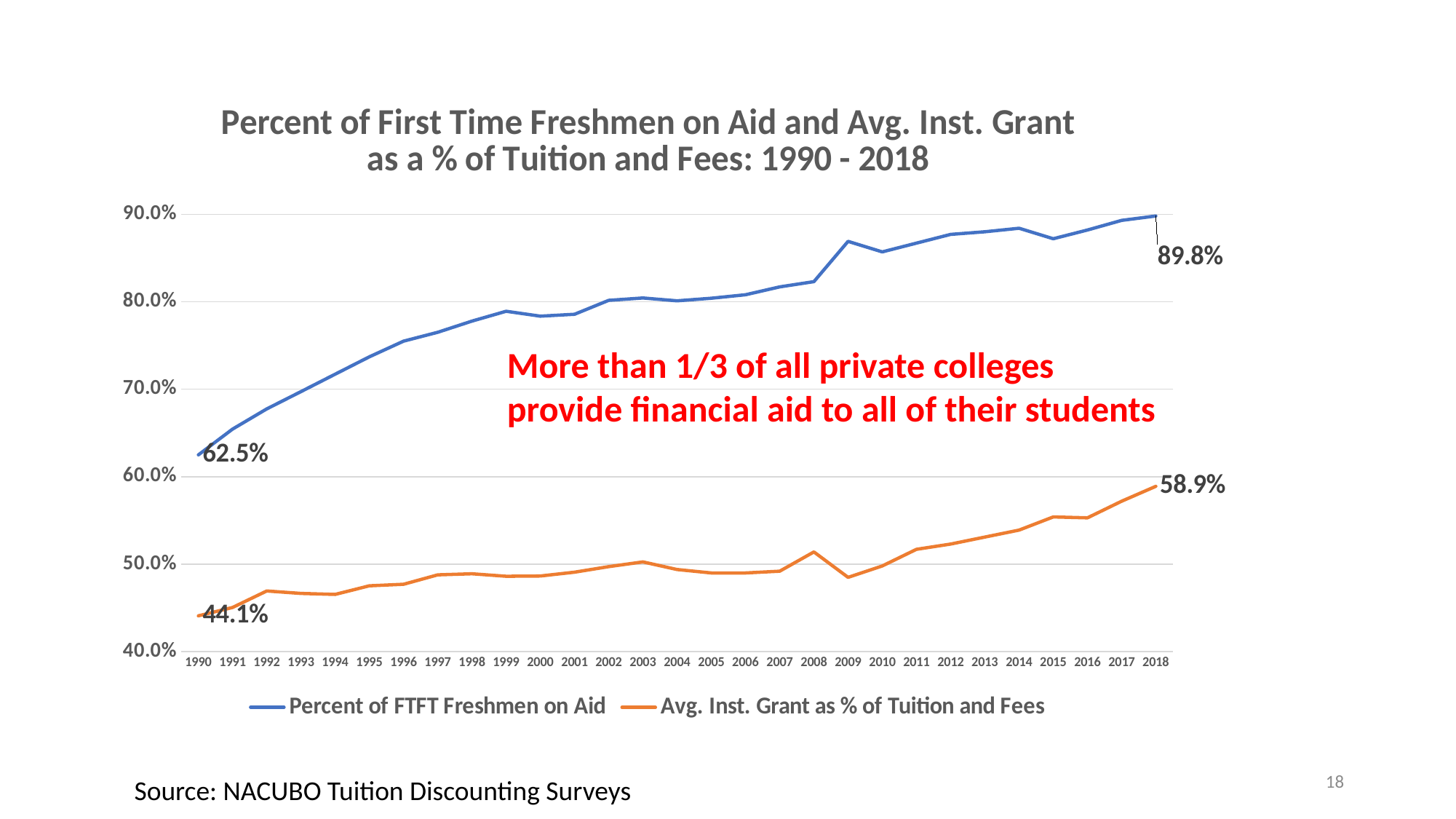
How many series does the legend list? 2 What is the value of Percent of FTFT Freshmen on Aid in 1990? 62.5% Is the value for Avg. Inst. Grant as % of Tuition and Fees in 2000 greater or less than 50.0%? less What is the value of Avg. Inst. Grant as % of Tuition and Fees in 2018? 58.9% What kind of chart is shown on the slide? Line chart Is the value for Percent of FTFT Freshmen on Aid in 2009 greater or less than 80.0%? greater By how many percentage points did Avg. Inst. Grant as % of Tuition and Fees change from 1990 to 2018? 14.8 percentage points In 2018, which series has the higher value: Percent of FTFT Freshmen on Aid or Avg. Inst. Grant as % of Tuition and Fees? Percent of FTFT Freshmen on Aid What is the value of Avg. Inst. Grant as % of Tuition and Fees in 1990? 44.1% By how many percentage points did Percent of FTFT Freshmen on Aid change from 1990 to 2018? 27.3 percentage points Does the Percent of FTFT Freshmen on Aid series generally rise or fall from 1990 to 2018? Rise What is the value of Percent of FTFT Freshmen on Aid in 2018? 89.8%